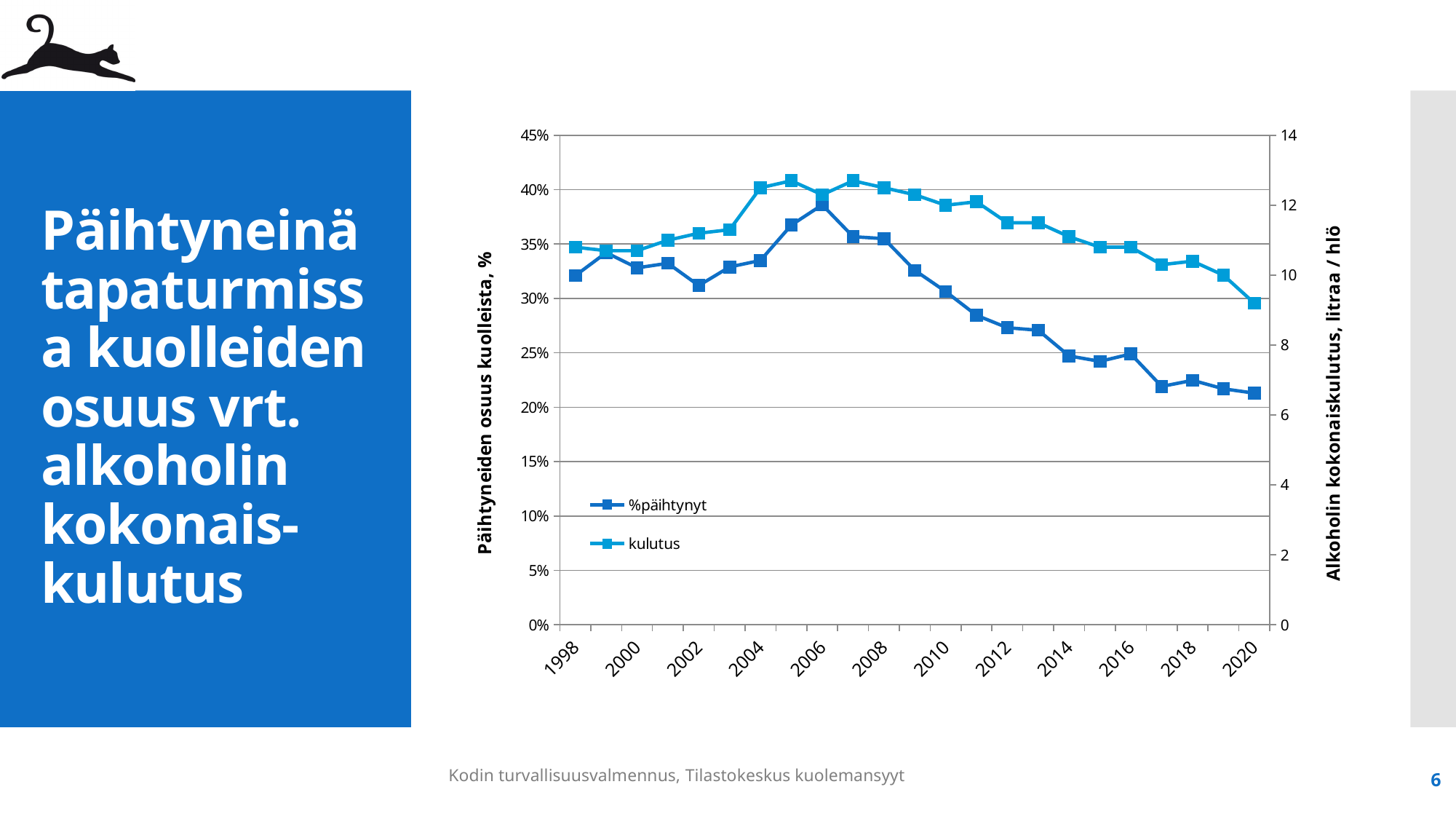
Is the value of %päihtynyt in 2006 greater or less than 35%? greater What kind of chart is shown on the slide? line chart How many series does the chart legend list? 2 Does the kulutus series rise or fall between 2008 and 2020? fall What are the two series named in the chart legend? %päihtynyt and kulutus In which year does the kulutus series reach its lowest value? 2020 Is the value of kulutus in 2020 greater or less than 10 litres per person? less In which year does the %päihtynyt series reach its highest value? 2006 How many year labels are shown on the x axis of the chart? 12 Which is larger: the %päihtynyt value in 2006 or in 2016? 2006 Is the value of %päihtynyt in 2020 greater or less than 25%? less What is the title of the right-hand vertical axis of the chart? Alkoholin kokonaiskulutus, litraa / hlö